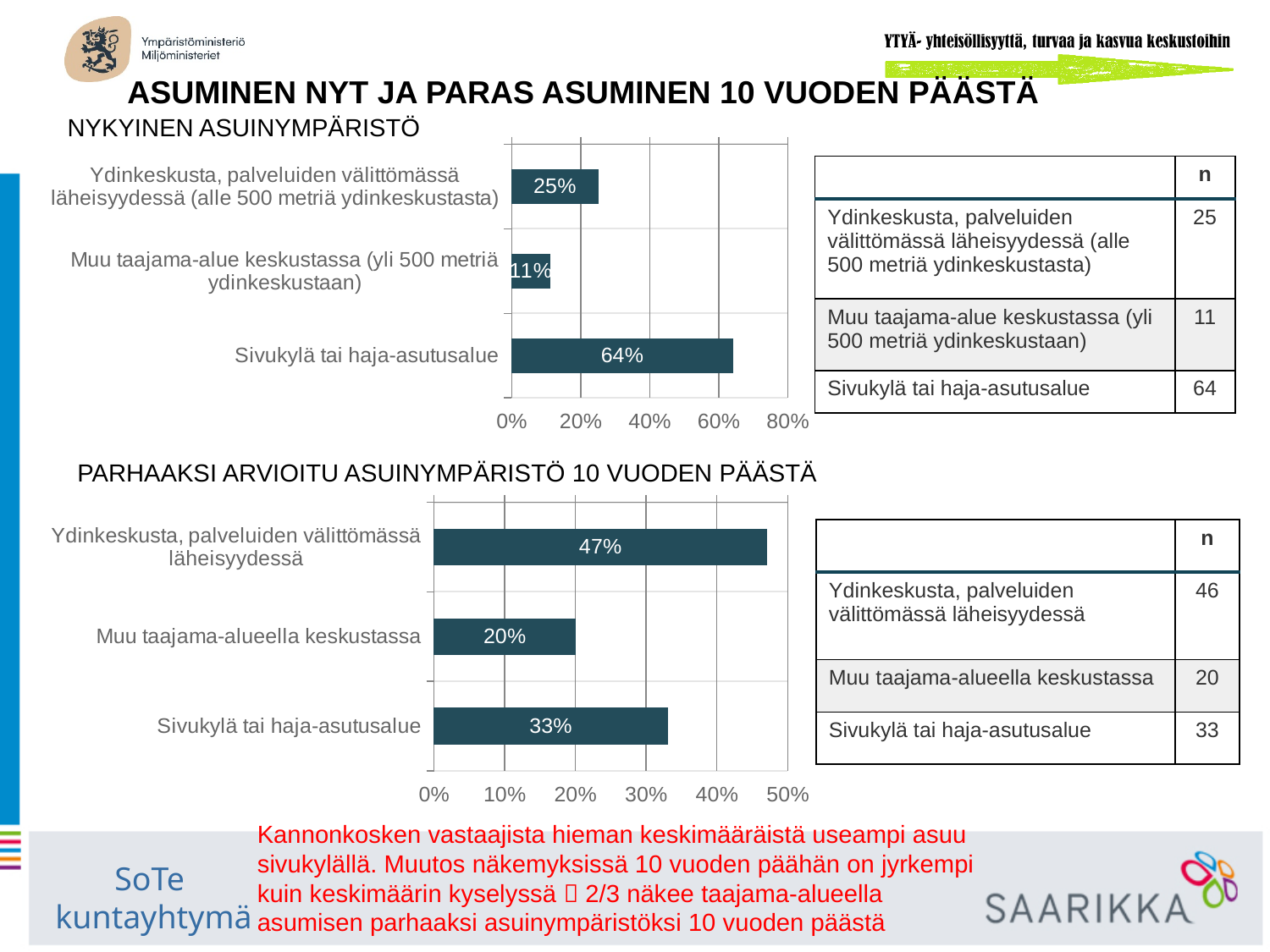
In the NYKYINEN ASUINYMPÄRISTÖ chart, which category has the lowest value? Muu taajama-alue keskustassa (yli 500 metriä ydinkeskustaan) In the PARHAAKSI ARVIOITU ASUINYMPÄRISTÖ 10 VUODEN PÄÄSTÄ chart, what is the value for Muu taajama-alueella keskustassa? 20% In the NYKYINEN ASUINYMPÄRISTÖ chart, which category has the highest value? Sivukylä tai haja-asutusalue In the PARHAAKSI ARVIOITU ASUINYMPÄRISTÖ 10 VUODEN PÄÄSTÄ chart, what is the difference between the values for Ydinkeskusta, palveluiden välittömässä läheisyydessä and Sivukylä tai haja-asutusalue? 14% In the NYKYINEN ASUINYMPÄRISTÖ chart, what is the difference between the values for Sivukylä tai haja-asutusalue and Ydinkeskusta, palveluiden välittömässä läheisyydessä? 39% In the PARHAAKSI ARVIOITU ASUINYMPÄRISTÖ 10 VUODEN PÄÄSTÄ chart, which category has the highest value? Ydinkeskusta, palveluiden välittömässä läheisyydessä What type of chart is the PARHAAKSI ARVIOITU ASUINYMPÄRISTÖ 10 VUODEN PÄÄSTÄ chart? Bar chart In the NYKYINEN ASUINYMPÄRISTÖ chart, what is the value for Sivukylä tai haja-asutusalue? 64% In the PARHAAKSI ARVIOITU ASUINYMPÄRISTÖ 10 VUODEN PÄÄSTÄ chart, what is the value for Ydinkeskusta, palveluiden välittömässä läheisyydessä? 47% In the PARHAAKSI ARVIOITU ASUINYMPÄRISTÖ 10 VUODEN PÄÄSTÄ chart, which is larger: the value for Sivukylä tai haja-asutusalue or Muu taajama-alueella keskustassa? Sivukylä tai haja-asutusalue How many categories does the NYKYINEN ASUINYMPÄRISTÖ chart show? 3 In the NYKYINEN ASUINYMPÄRISTÖ chart, what is the value for Muu taajama-alue keskustassa (yli 500 metriä ydinkeskustaan)? 11%